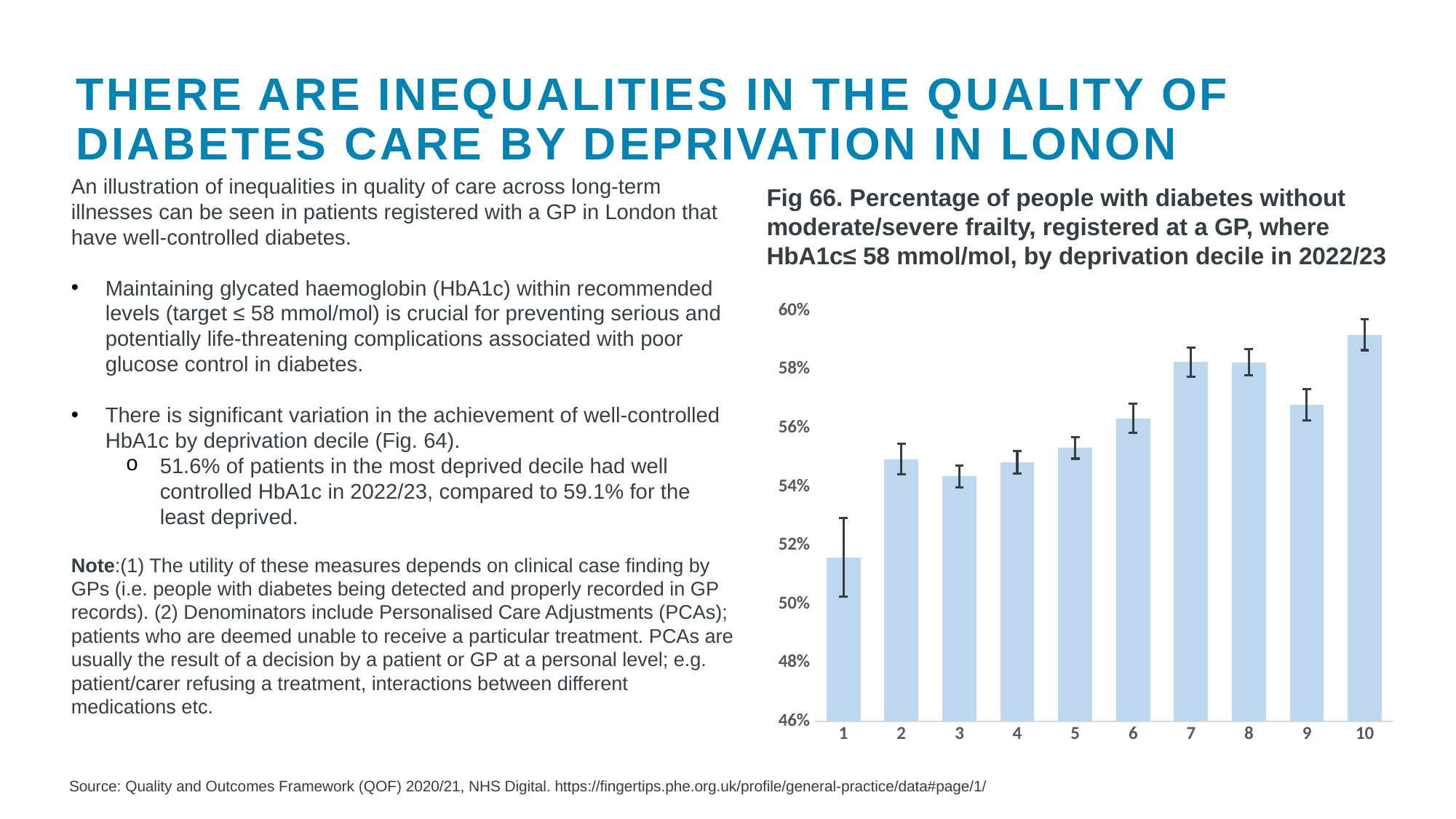
What kind of chart is shown in Fig 66? bar chart Is the value for decile 1 greater or less than 52%? less Which deprivation decile has the lowest percentage in the chart? 1 Which has the larger value, decile 8 or decile 9? decile 8 Is the value for decile 1 greater or less than 50%? greater Is the value for decile 9 greater or less than 58%? less How many deprivation deciles are plotted on the x axis of the chart? 10 What year does the chart title say the data is for? 2022/23 Which deprivation decile has the highest percentage in the chart? 10 Do the values generally rise or fall as the deprivation decile increases from 1 to 10? rise